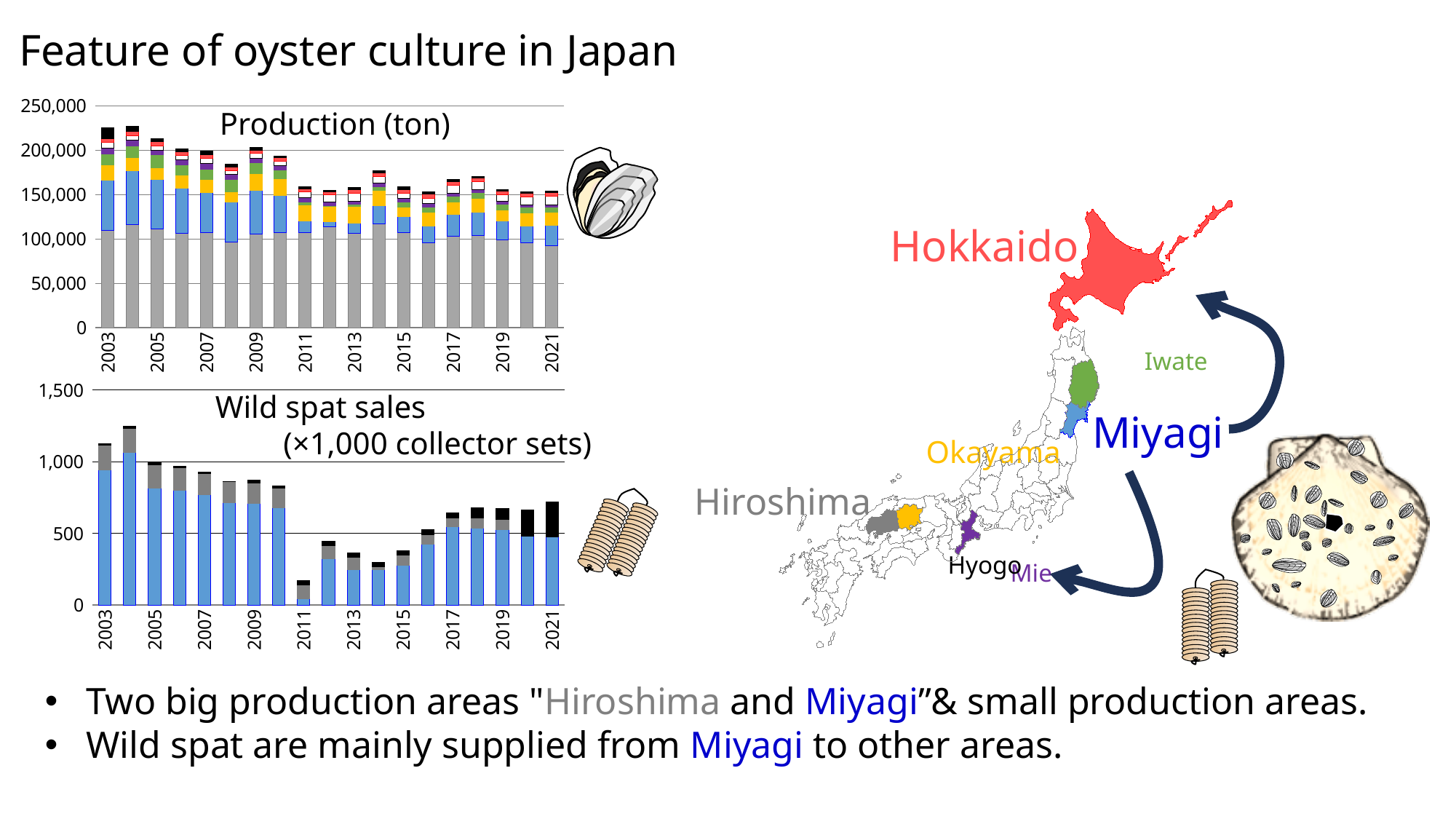
In the "Wild spat sales" chart, is the total for 2004 greater or less than 1,000? greater In the "Production (ton)" chart, which year has the larger total production, 2003 or 2011? 2003 In the "Wild spat sales" chart, which year has the lowest total? 2011 In the "Production (ton)" chart, how many years (bars) are plotted? 19 In the "Production (ton)" chart, is the total production for 2011 greater or less than 200,000? less In the "Wild spat sales" chart, do the totals rise or fall from 2003 to 2011? fall What kind of chart is the "Production (ton)" chart? stacked bar chart In the "Production (ton)" chart, is the total production for 2003 greater or less than 200,000? greater What kind of chart is the "Wild spat sales" chart? stacked bar chart What unit is given in the title of the "Wild spat sales" chart? ×1,000 collector sets In the "Wild spat sales" chart, which year has the highest total? 2004